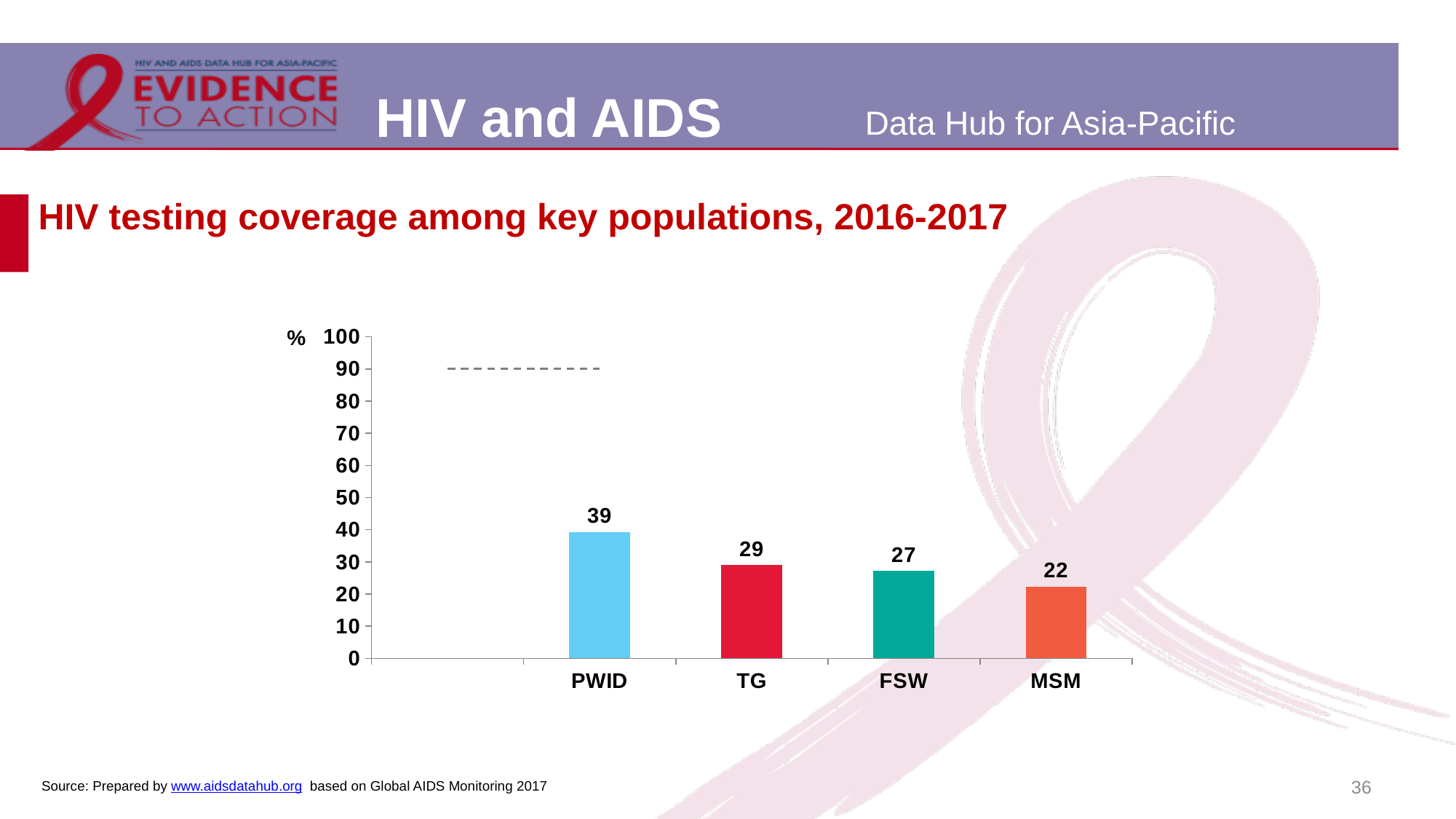
What is the HIV testing coverage value for FSW? 27 What is the HIV testing coverage value for MSM? 22 Which has a higher value, TG or FSW? TG Is the value for PWID greater or less than 50? less What is the HIV testing coverage value for PWID? 39 What kind of chart is shown on the slide? bar chart Which key population has the lowest HIV testing coverage? MSM How many key populations are shown on the chart? 4 What is the title of the chart on the slide? HIV testing coverage among key populations, 2016-2017 What is the HIV testing coverage value for TG? 29 Which key population has the highest HIV testing coverage? PWID What is the difference between the values for PWID and MSM? 17